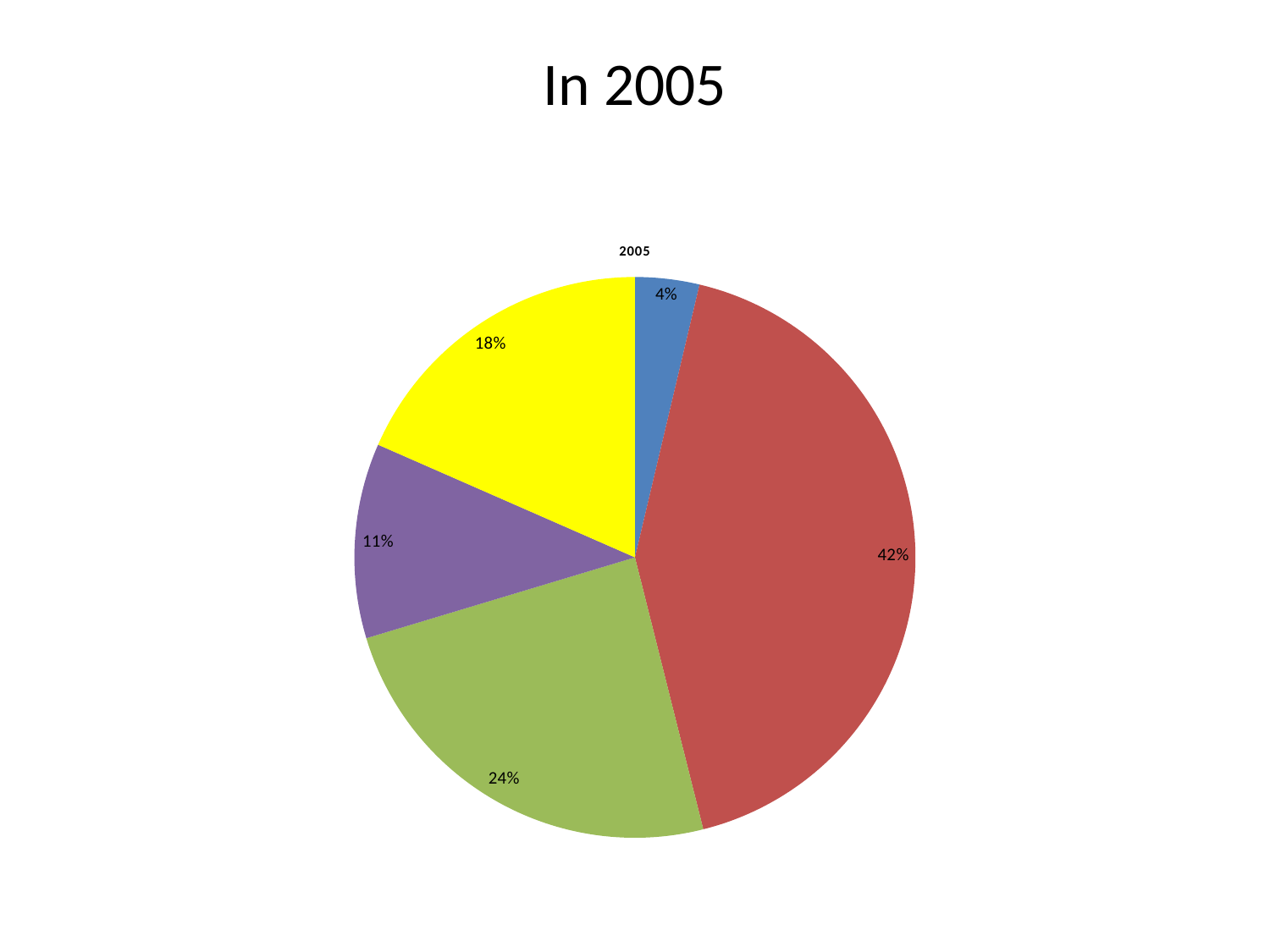
What percentage is shown on the blue slice? 4% What percentage is shown on the green slice? 24% What percentage is shown on the yellow slice? 18% What percentage is shown on the red slice? 42% Which colour slice is the largest? red What is the title of the chart? 2005 What is the difference between the red slice and the green slice? 18% How many slices does the pie chart have? 5 What kind of chart is shown on the slide? pie chart Which colour slice is the smallest? blue What percentage is shown on the purple slice? 11% Which is larger, the yellow slice or the purple slice? yellow